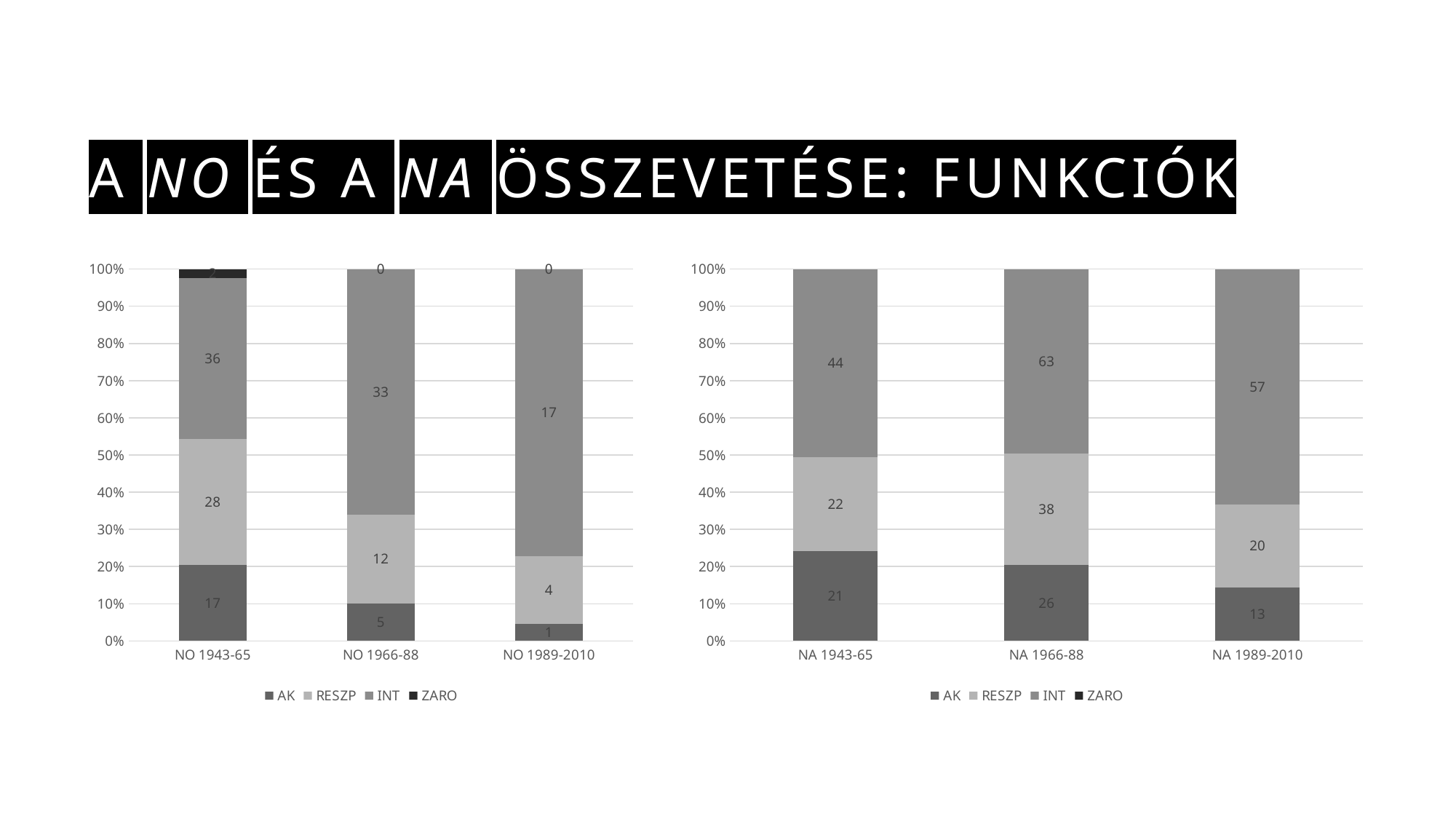
In the left chart (NO), which is larger: RESZP for NO 1943-65 or RESZP for NO 1966-88? NO 1943-65 In the right chart (NA), which category has the highest INT value? NA 1966-88 In the left chart (NO), what is the total of the labelled values in the NO 1966-88 bar? 50 What kind of chart is the right chart (NA)? Stacked bar chart In the right chart (NA), what is the value of RESZP for NA 1966-88? 38 How many categories are shown on the x axis of the right chart (NA)? 3 In the left chart (NO), which category has the lowest RESZP value? NO 1989-2010 In the left chart (NO), what is the value of AK for NO 1989-2010? 1 In the right chart (NA), what is the value of INT for NA 1989-2010? 57 In the left chart (NO), what is the value of INT for NO 1966-88? 33 In the right chart (NA), what is the difference between the AK values for NA 1966-88 and NA 1989-2010? 13 How many series does the legend of the left chart (NO) list? 4